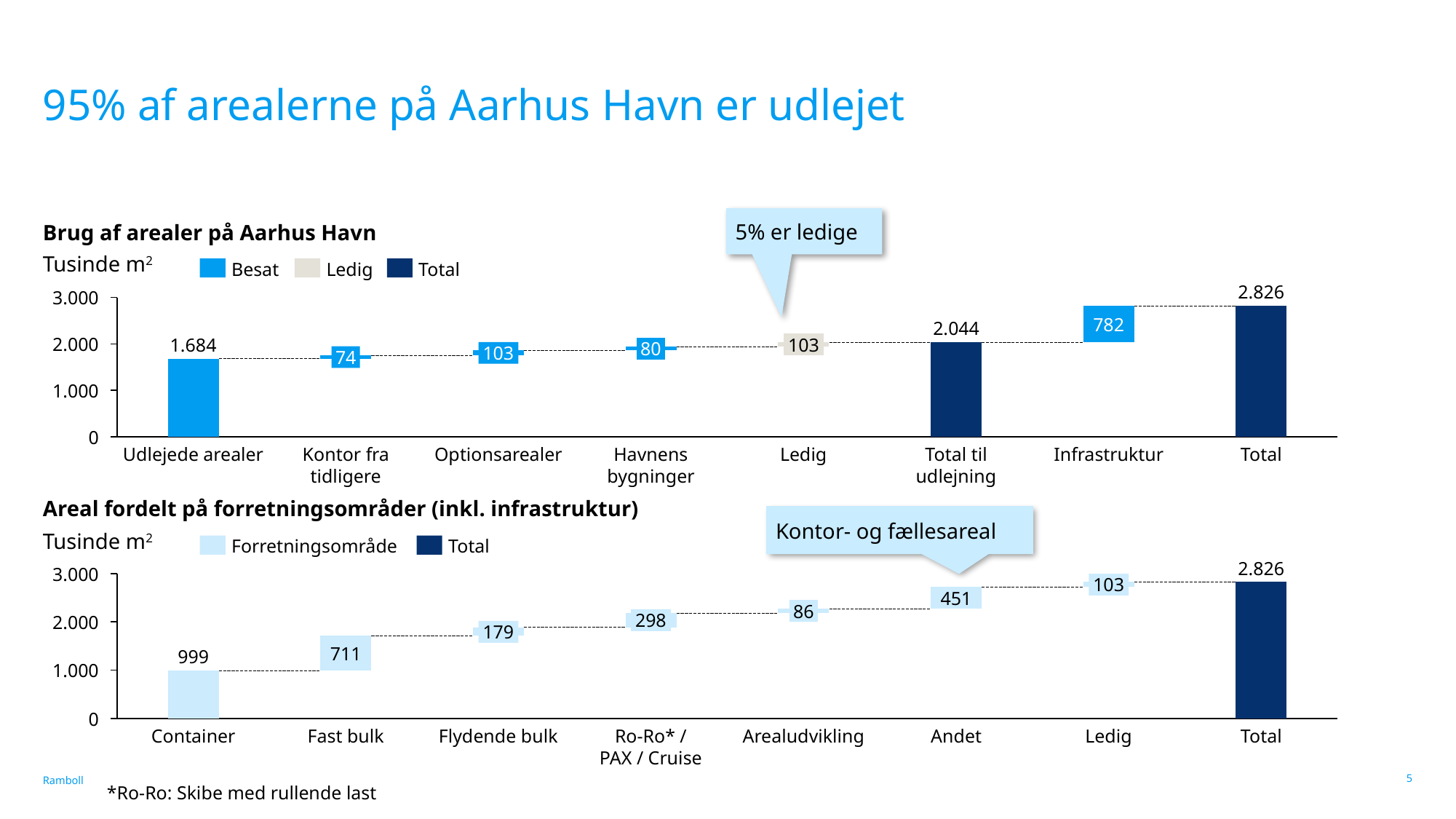
In the chart 'Areal fordelt på forretningsområder (inkl. infrastruktur)', how many categories are shown on the x axis? 8 In the chart 'Areal fordelt på forretningsområder (inkl. infrastruktur)', which is larger, Fast bulk or Ro-Ro* / PAX / Cruise? Fast bulk In the chart 'Brug af arealer på Aarhus Havn', what is the value for Total til udlejning? 2.044 What kind of chart is 'Areal fordelt på forretningsområder (inkl. infrastruktur)'? Bar chart In the chart 'Brug af arealer på Aarhus Havn', what is the value for Udlejede arealer? 1.684 In the chart 'Areal fordelt på forretningsområder (inkl. infrastruktur)', what is the difference between Container and Fast bulk? 288 In the chart 'Areal fordelt på forretningsområder (inkl. infrastruktur)', what is the value for Container? 999 In the chart 'Brug af arealer på Aarhus Havn', what is the difference between Total and Total til udlejning? 782 In the chart 'Brug af arealer på Aarhus Havn', which category has the lowest value? Kontor fra tidligere In the chart 'Brug af arealer på Aarhus Havn', how many series does the legend list? 3 In the chart 'Brug af arealer på Aarhus Havn', what is the value for Infrastruktur? 782 In the chart 'Areal fordelt på forretningsområder (inkl. infrastruktur)', what is the value for Andet? 451